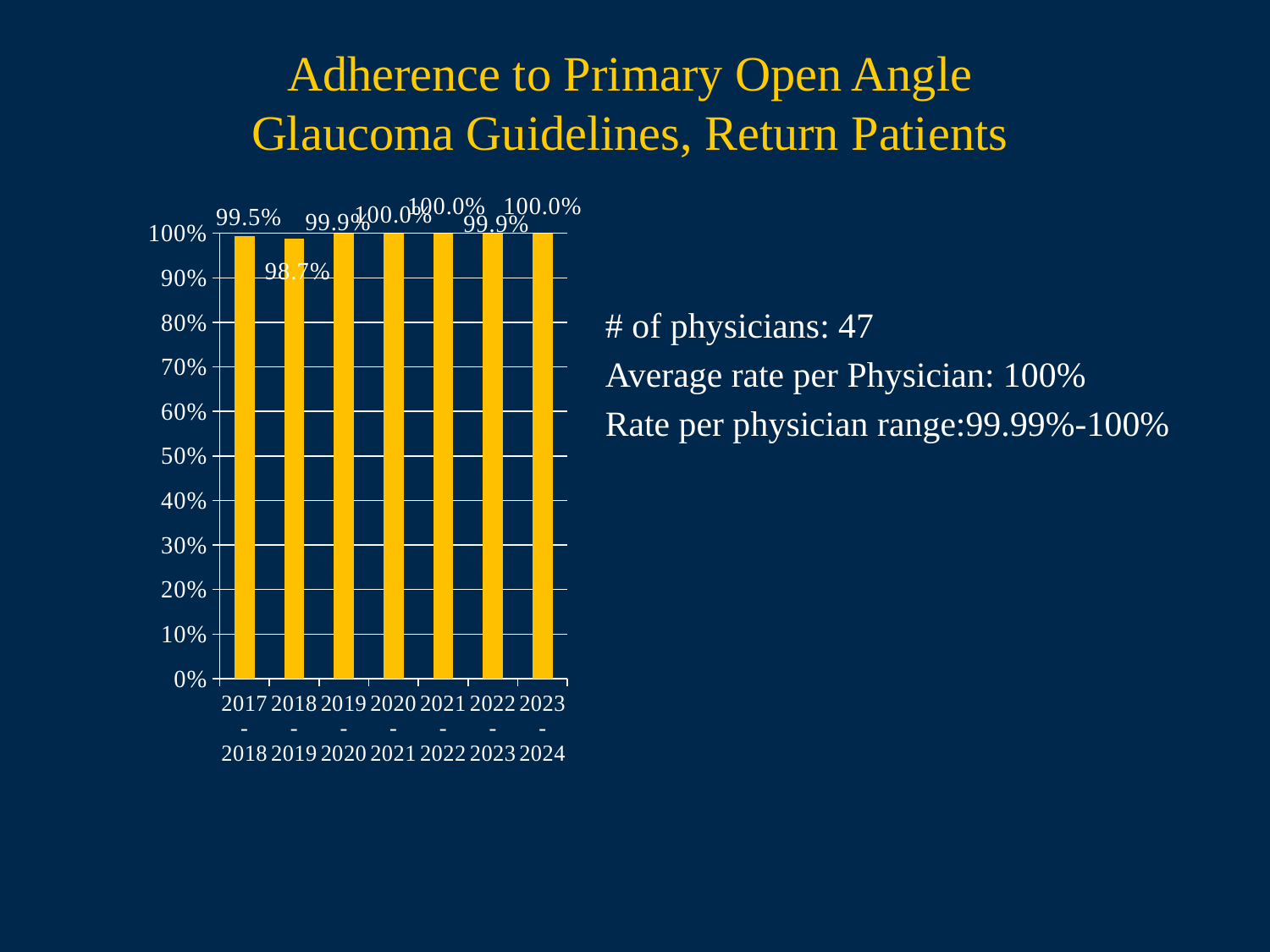
Which is larger, the adherence rate for 2017-2018 or for 2018-2019? 2017-2018 What is the difference between the adherence rates for 2017-2018 and 2018-2019? 0.8 percentage points What is the adherence rate for 2023-2024? 100.0% How many periods are shown on the x axis of the chart? 7 What is the adherence rate for 2017-2018? 99.5% What kind of chart is shown on the slide? Bar chart Is the value for 2018-2019 greater or less than 90%? greater What is the adherence rate for 2022-2023? 99.9% What is the adherence rate for 2018-2019? 98.7% Which period has the lowest adherence rate? 2018-2019 What is the adherence rate for 2021-2022? 100.0% What colour are the bars in the chart? Yellow